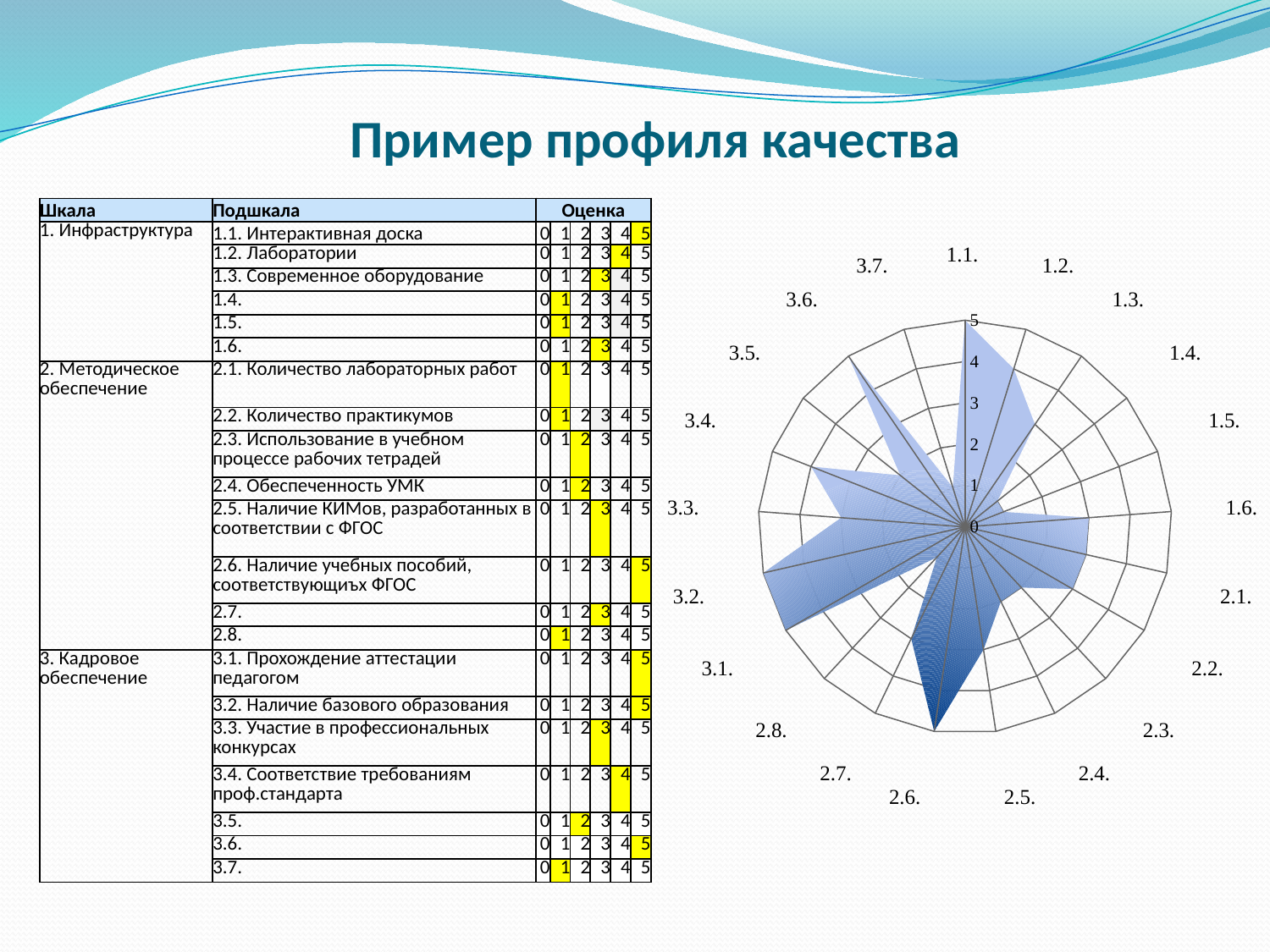
Is the value for 1.4. on the radar chart greater or less than 2? less How many categories (subscales) are plotted around the radar chart? 21 What is the lowest value marked on the radial axis of the radar chart? 0 What kind of chart is shown on the right side of the slide? Radar chart What is the highest value marked on the radial axis of the radar chart? 5 Is the value for 1.1. on the radar chart greater or less than 4? greater Is the value for 2.5. on the radar chart greater or less than 2? greater On the radar chart, which has the larger value: 2.6. or 2.1.? 2.6. On the radar chart, which has the larger value: 1.1. or 1.4.? 1.1.